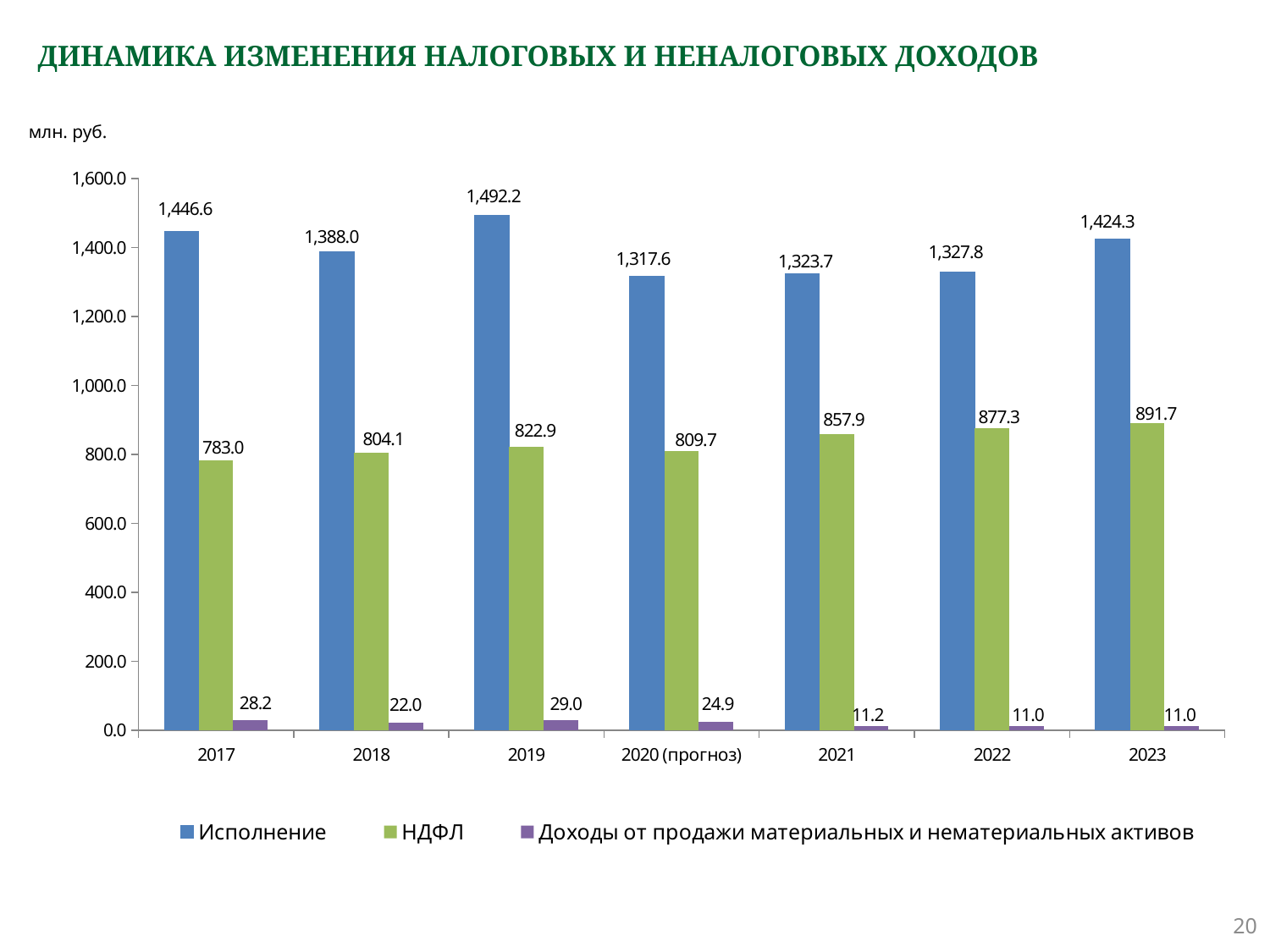
What unit is indicated above the chart? млн. руб. Is the value of Исполнение for 2023 greater or less than 1,400.0? greater What is the value of НДФЛ for 2021? 857.9 What kind of chart is shown on the slide? Bar chart How many series does the legend list? 3 In which year is Исполнение the highest? 2019 Which is larger: НДФЛ in 2022 or НДФЛ in 2018? НДФЛ in 2022 How many years are shown on the x axis? 7 What is the value of Исполнение for 2019? 1,492.2 What is the value of Доходы от продажи материальных и нематериальных активов for 2020 (прогноз)? 24.9 What is the difference between Исполнение in 2019 and Исполнение in 2020 (прогноз)? 174.6 In which year is НДФЛ the lowest? 2017